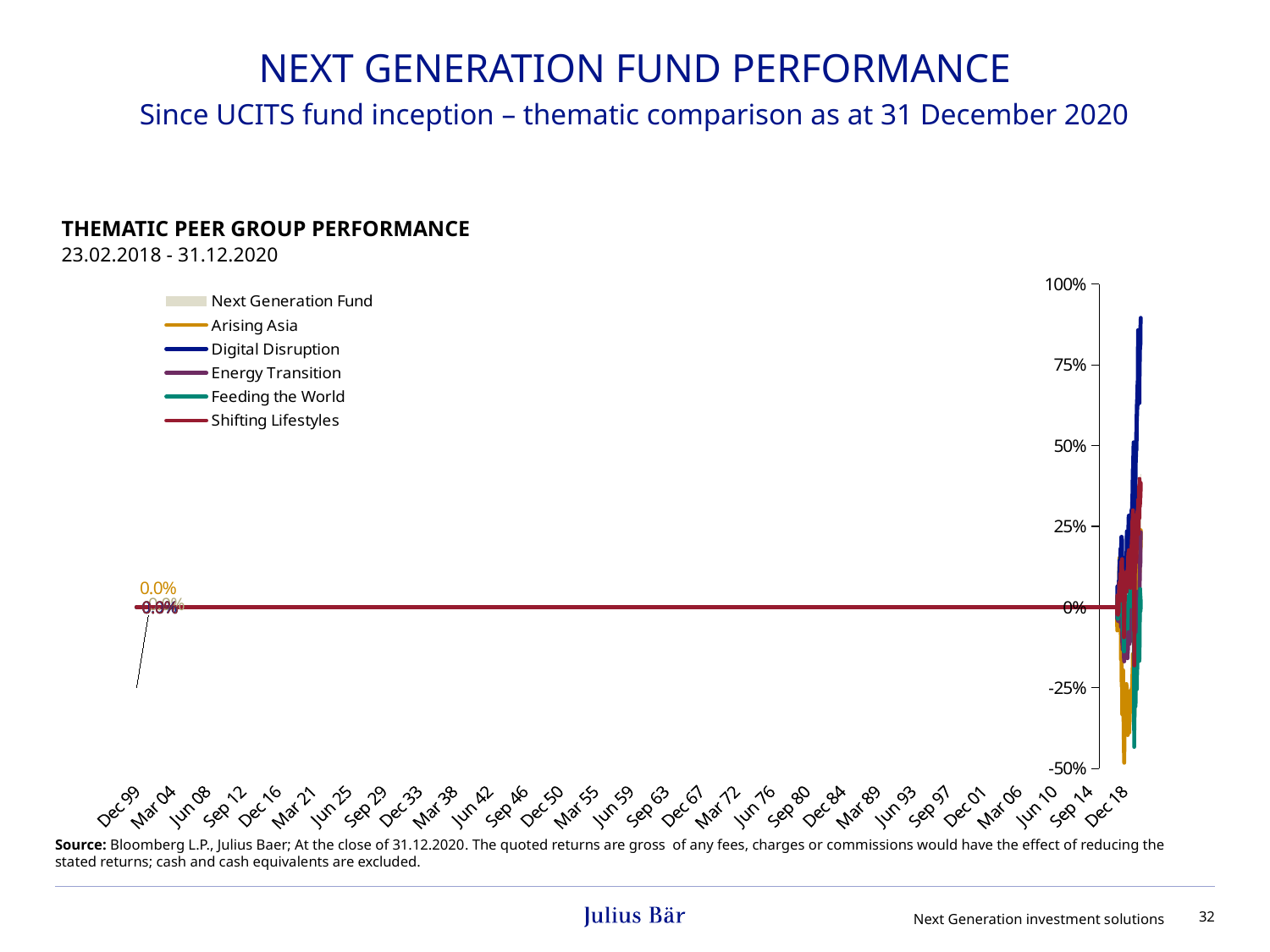
Which series reaches the highest value on the chart? Digital Disruption How many series does the legend list? 6 Is the peak value of the Shifting Lifestyles line greater or less than 50%? less Is the lowest value of the Arising Asia line greater or less than -25%? less What is the highest value shown on the vertical axis? 100% Which series reaches a higher peak, Digital Disruption or Feeding the World? Digital Disruption Is the peak value of the Digital Disruption line greater or less than 75%? greater What kind of chart is shown on the slide? line chart What date range is shown under the chart title? 23.02.2018 - 31.12.2020 What is the title of the chart? THEMATIC PEER GROUP PERFORMANCE